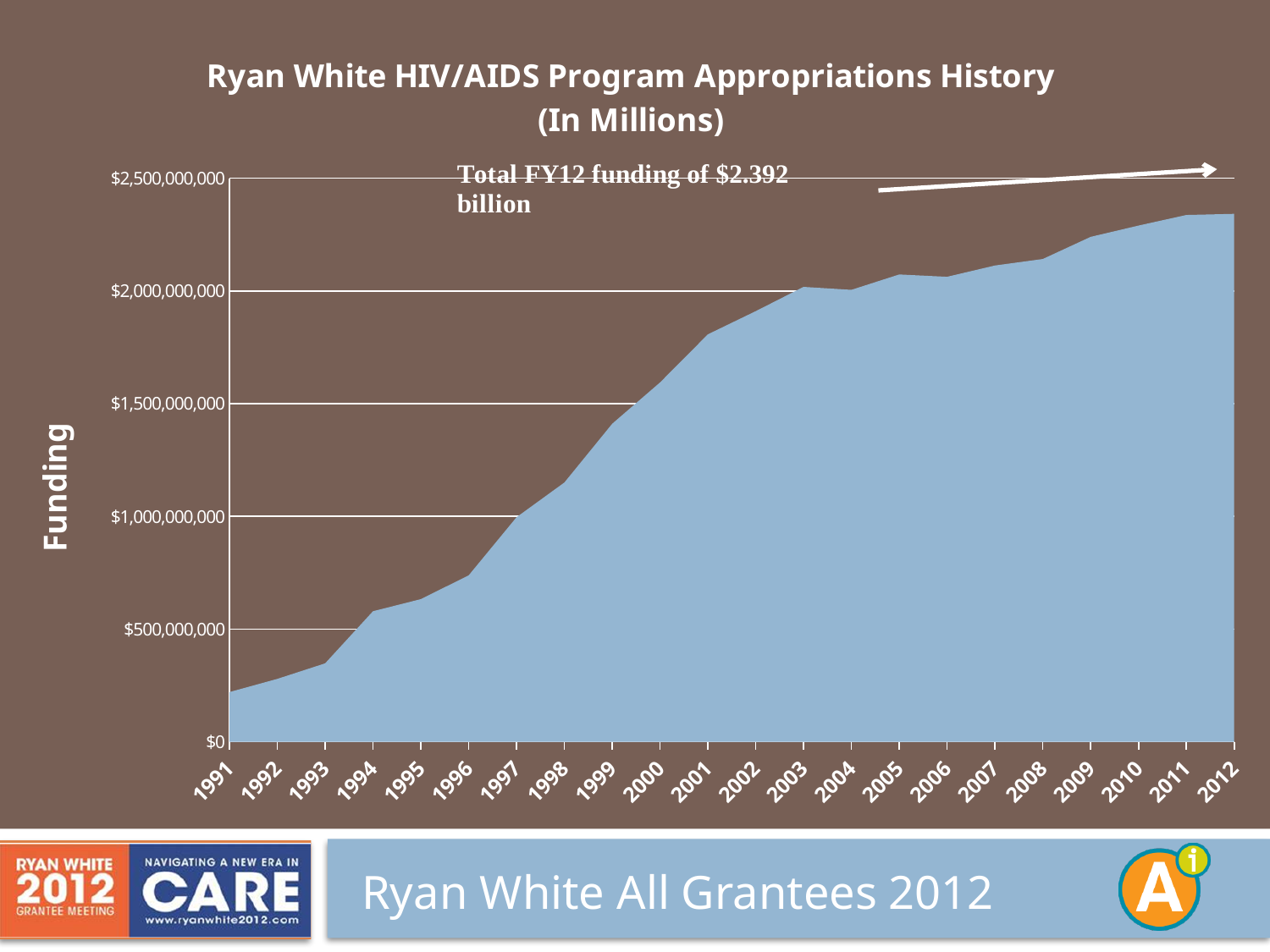
Is the funding value for 1996 greater or less than $1,000,000,000? less What kind of chart is shown on the slide? area chart Is the funding value for 2009 greater or less than $2,000,000,000? greater How many years are shown along the x axis of the chart? 22 Which year has the larger funding value, 1998 or 2005? 2005 Which year has the lowest funding value in the chart? 1991 Is the funding value for 2001 greater or less than $1,500,000,000? greater What is the label on the vertical axis of the chart? Funding According to the annotation on the chart, what is the total FY12 funding? $2.392 billion Do the funding values generally rise or fall from 1991 to 2012? rise